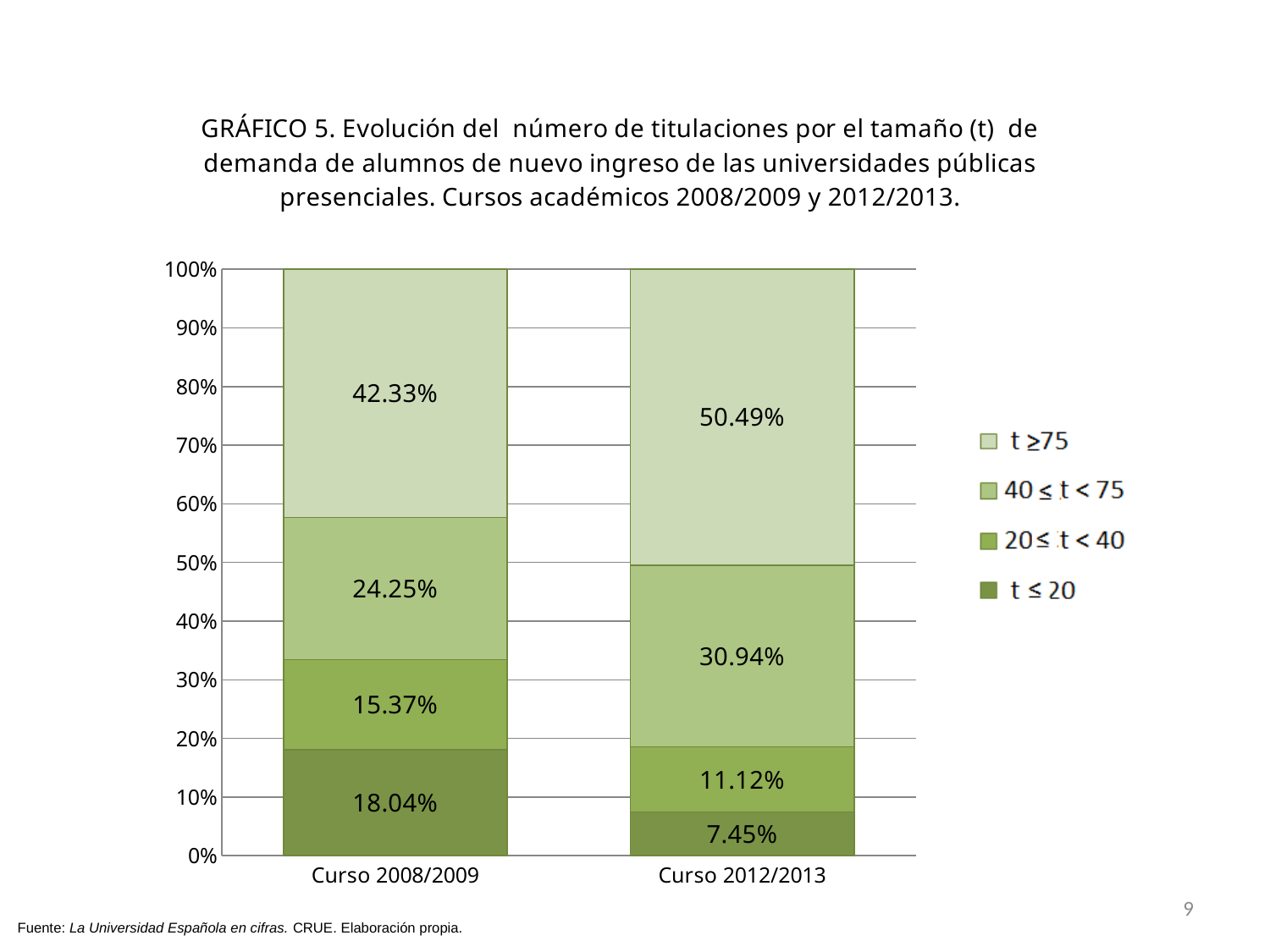
Which series has the smallest share in Curso 2012/2013? t ≤ 20 How many series does the legend list? 4 What kind of chart is shown on the slide? Stacked bar chart Did the share of t ≤ 20 rise or fall from Curso 2008/2009 to Curso 2012/2013? Fall What is the value for t ≥75 in Curso 2012/2013? 50.49% What is the value for 40 ≤ t < 75 in Curso 2012/2013? 30.94% What is the value for 20 ≤ t < 40 in Curso 2008/2009? 15.37% What is the value for t ≤ 20 in Curso 2008/2009? 18.04% How many academic courses (categories) are plotted on the x axis? 2 Which series has the largest share in Curso 2008/2009? t ≥75 By how many percentage points did the t ≥75 share change from Curso 2008/2009 to Curso 2012/2013? 8.16 percentage points Which is larger: the t ≤ 20 share in Curso 2008/2009 or in Curso 2012/2013? Curso 2008/2009